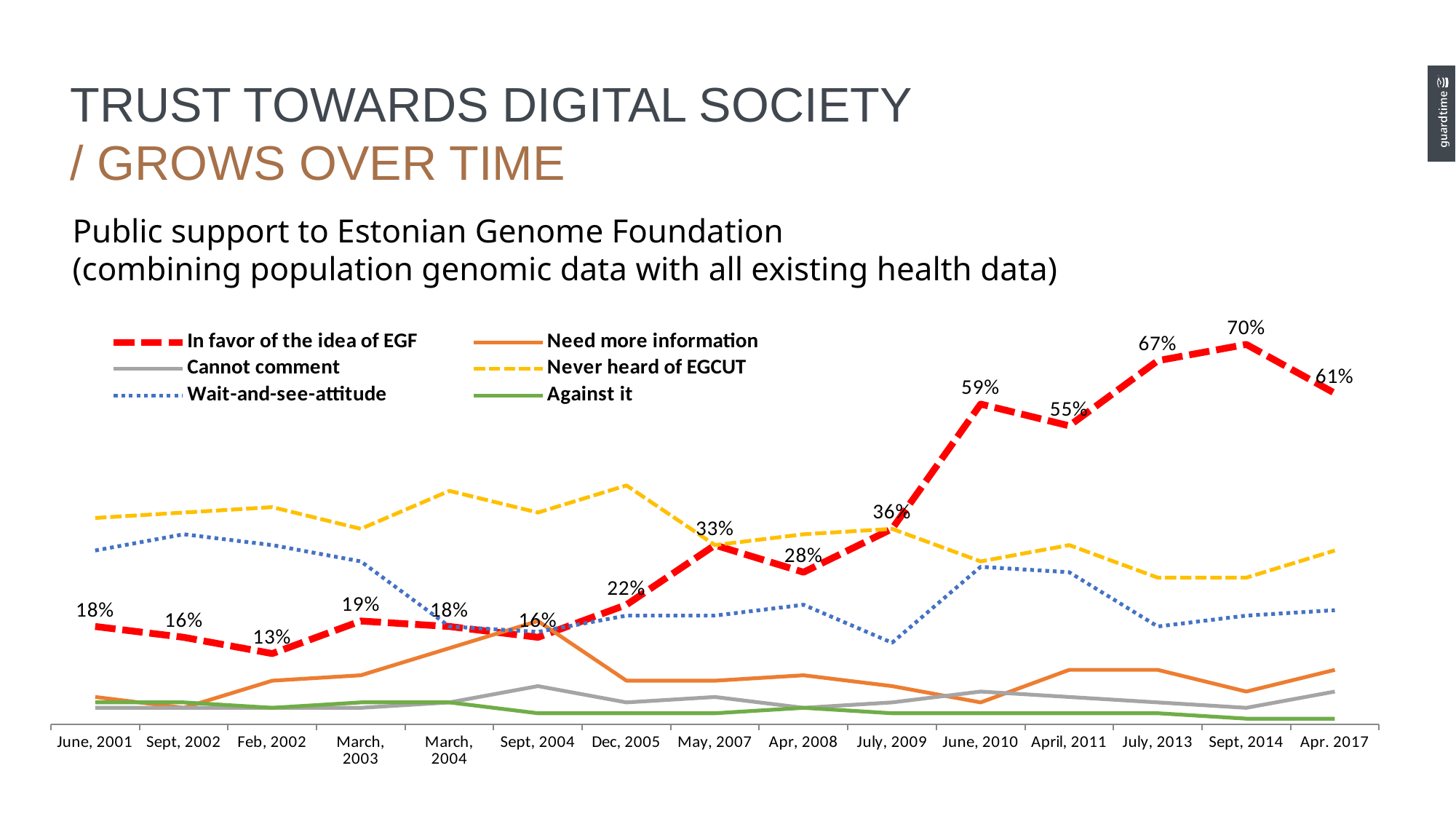
What is the value for 'In favor of the idea of EGF' in Apr. 2017? 61% At which time point is the 'In favor of the idea of EGF' series lowest? Feb, 2002 At which time point is the 'In favor of the idea of EGF' series highest? Sept, 2014 How many series does the legend list? 6 What type of chart is shown on the slide? Line chart What is the value for 'In favor of the idea of EGF' in Sept, 2014? 70% Overall, does the 'In favor of the idea of EGF' series rise or fall from June, 2001 to Apr. 2017? Rise What is the difference between the 'In favor of the idea of EGF' values in Sept, 2014 and June, 2001? 52% Which series is drawn as a thick red dashed line? In favor of the idea of EGF Which is larger for 'In favor of the idea of EGF': the value in June, 2010 or in April, 2011? June, 2010 How many time points are shown on the x axis? 15 What is the value for 'In favor of the idea of EGF' in June, 2001? 18%